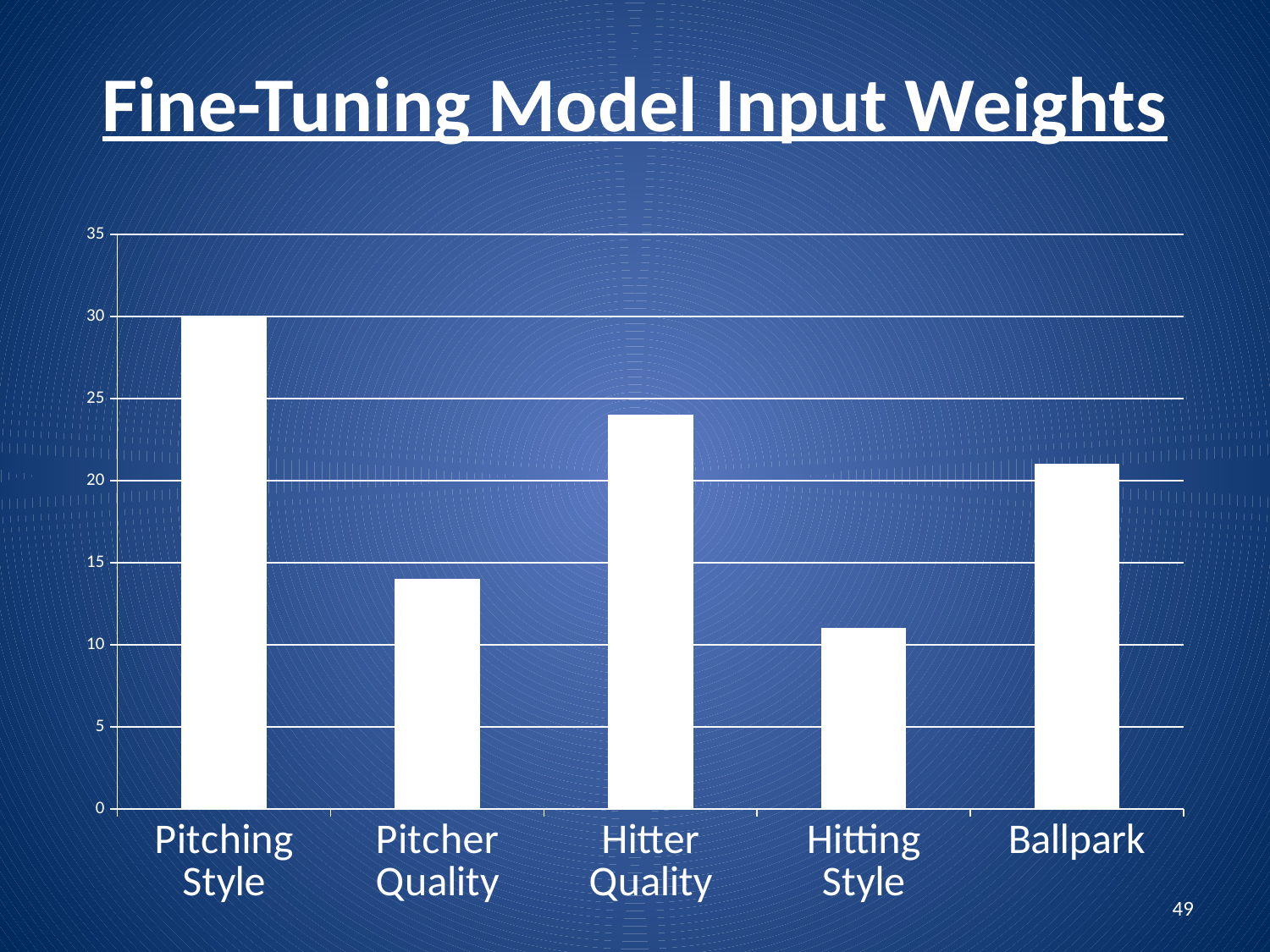
Is the value for Pitcher Quality greater or less than 15? less What is the value for Pitching Style? 30 Which category has the lowest value? Hitting Style What kind of chart is shown on the slide? bar chart What is the title of the slide? Fine-Tuning Model Input Weights Which is larger, the value for Hitter Quality or the value for Ballpark? Hitter Quality Which is larger, the value for Pitcher Quality or the value for Hitting Style? Pitcher Quality How many categories are shown on the x axis? 5 Which category has the highest value? Pitching Style Is the value for Hitting Style greater or less than 10? greater Is the value for Hitter Quality greater or less than 20? greater